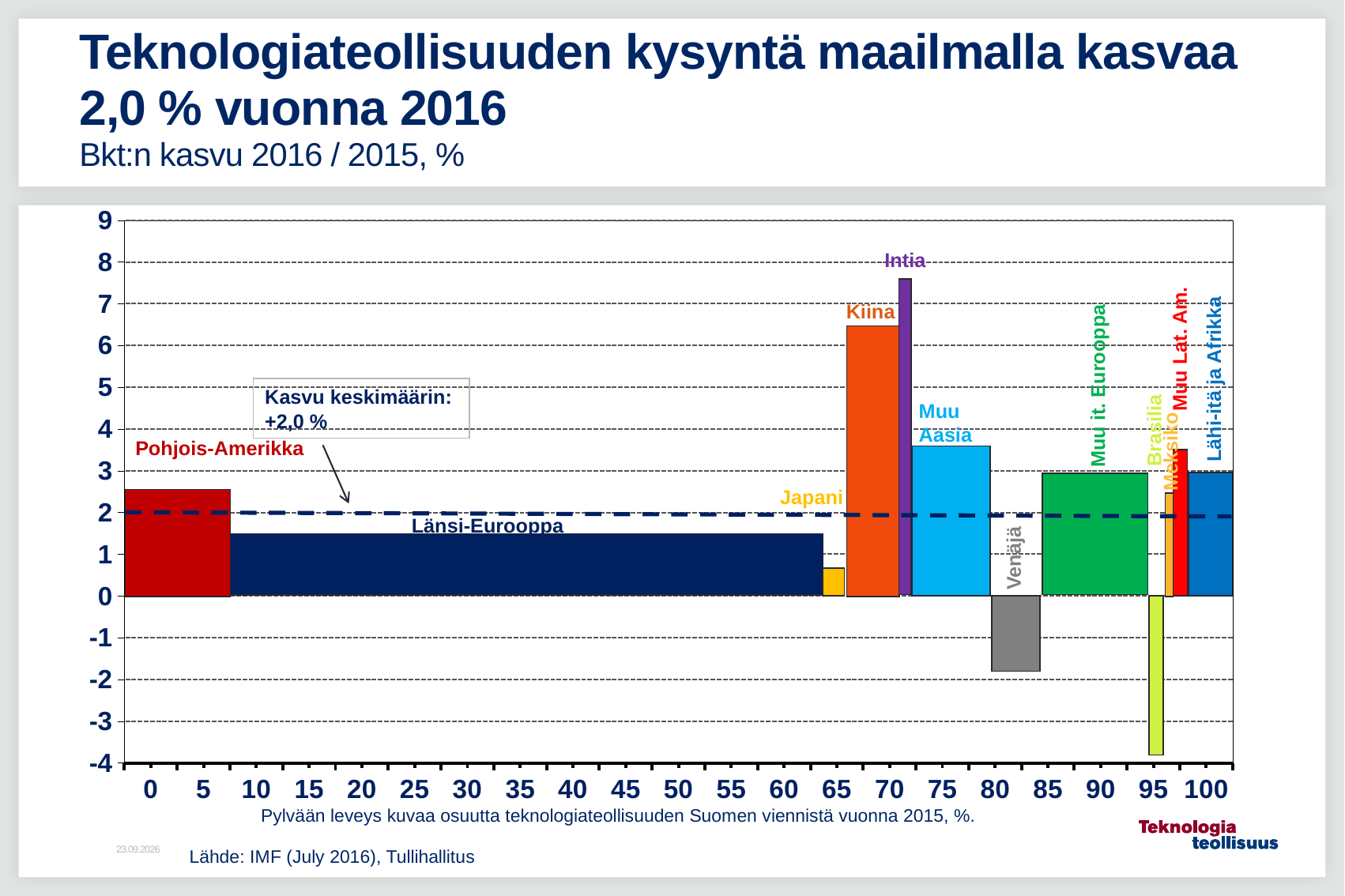
Is the value for Japani greater or less than 1? less What average growth does the dashed line in the chart represent? +2,0 % How many regions are plotted as bars in the chart? 12 Which has higher GDP growth, Kiina or Intia? Intia What kind of chart is shown on the slide? bar chart Is the value for Muu Aasia greater or less than 3? greater Is the value for Länsi-Eurooppa greater or less than 2? less Which region has the lowest GDP growth in the chart? Brasilia Which has lower GDP growth, Venäjä or Brasilia? Brasilia Which region has the highest GDP growth in the chart? Intia